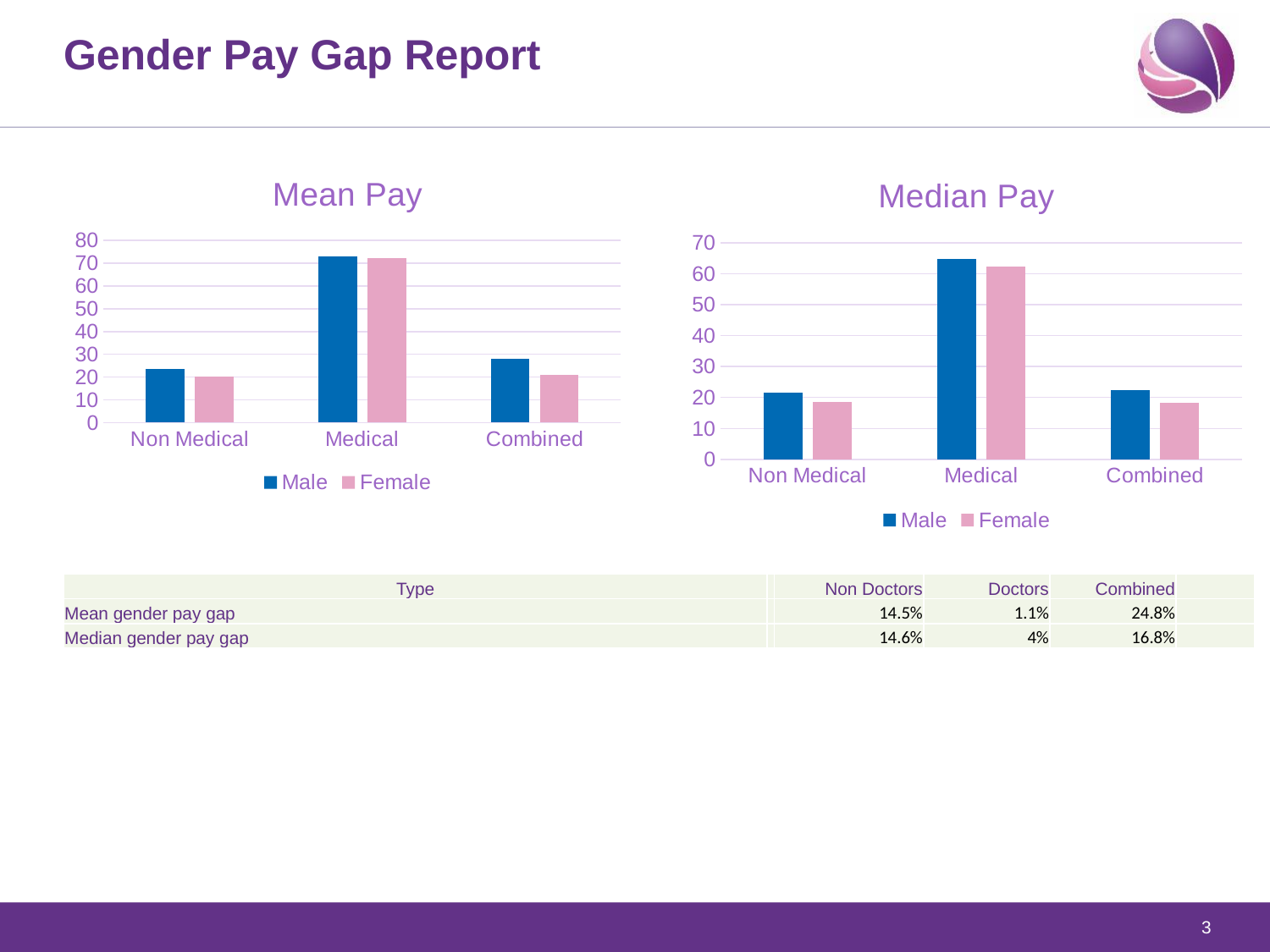
In the Median Pay chart, is the Male value for Non Medical greater or less than 30? less In the Mean Pay chart, which is larger for Combined, the Male bar or the Female bar? Male What are the two legend entries in the Median Pay chart? Male and Female In the Median Pay chart, which is larger for Non Medical, the Male bar or the Female bar? Male What kind of chart is the Mean Pay chart? bar chart In the Mean Pay chart, is the Male value for Medical greater or less than 60? greater In the Median Pay chart, is the Female value for Medical greater or less than 50? greater How many categories are shown on the x axis of the Median Pay chart? 3 In the Mean Pay chart, which category has the highest Male bar? Medical How many series does the legend of the Mean Pay chart list? 2 In the Median Pay chart, which category has the highest Female bar? Medical